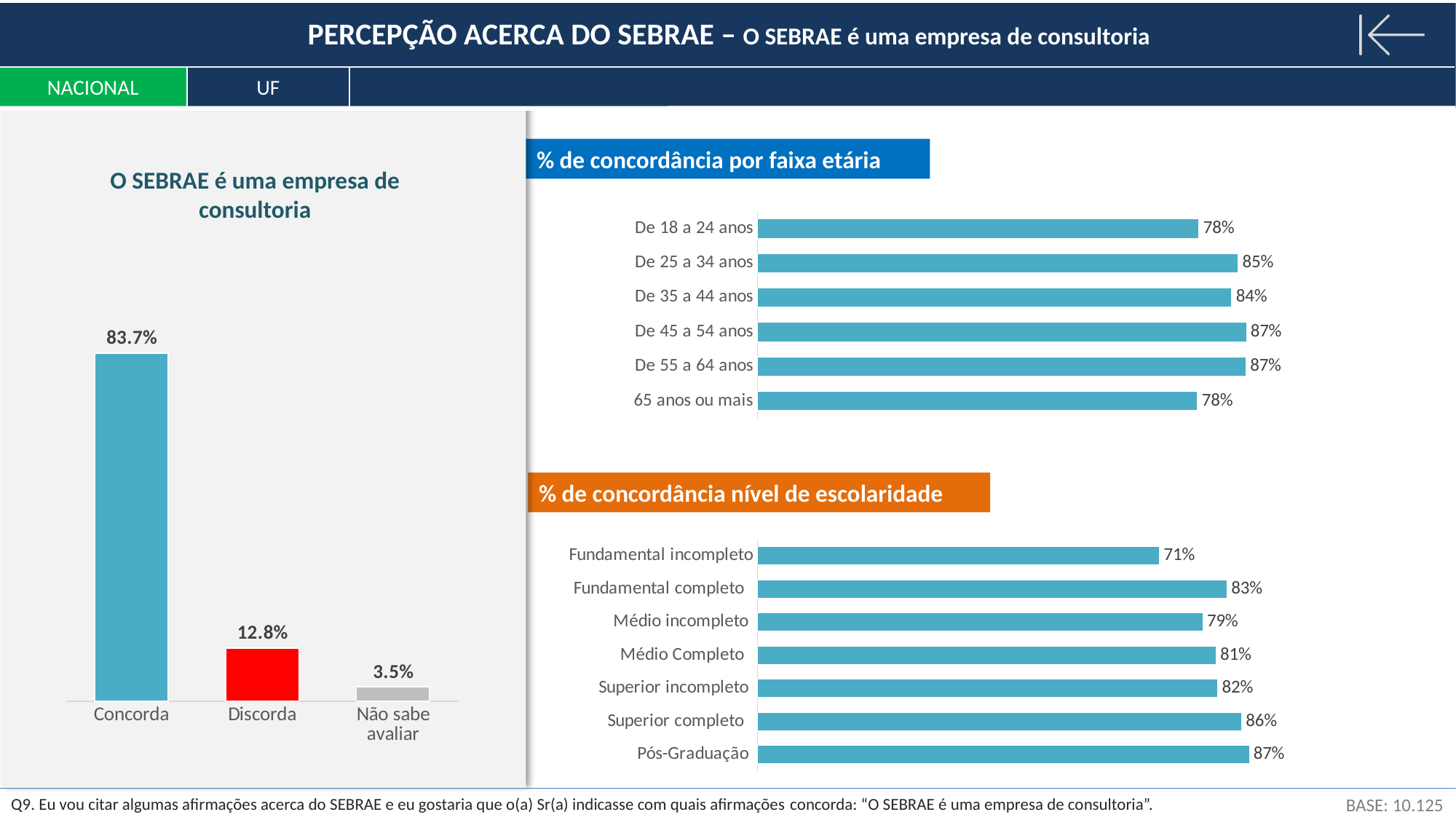
In the chart "% de concordância por faixa etária", what is the value for De 25 a 34 anos? 85% In the chart titled "O SEBRAE é uma empresa de consultoria", what kind of chart is it? Bar chart In the chart "% de concordância nível de escolaridade", what is the difference between Superior completo and Médio incompleto? 7% In the chart "% de concordância por faixa etária", how many age groups are shown? 6 In the chart titled "O SEBRAE é uma empresa de consultoria", what is the difference between Concorda and Discorda? 70.9% In the chart titled "O SEBRAE é uma empresa de consultoria", how many categories are shown? 3 In the chart "% de concordância nível de escolaridade", which category has the highest value? Pós-Graduação In the chart "% de concordância por faixa etária", what is the value for 65 anos ou mais? 78% In the chart titled "O SEBRAE é uma empresa de consultoria", what is the value for Concorda? 83.7% In the chart titled "O SEBRAE é uma empresa de consultoria", what is the value for Não sabe avaliar? 3.5% In the chart "% de concordância por faixa etária", which is larger: De 35 a 44 anos or De 18 a 24 anos? De 35 a 44 anos In the chart "% de concordância nível de escolaridade", which category has the lowest value? Fundamental incompleto